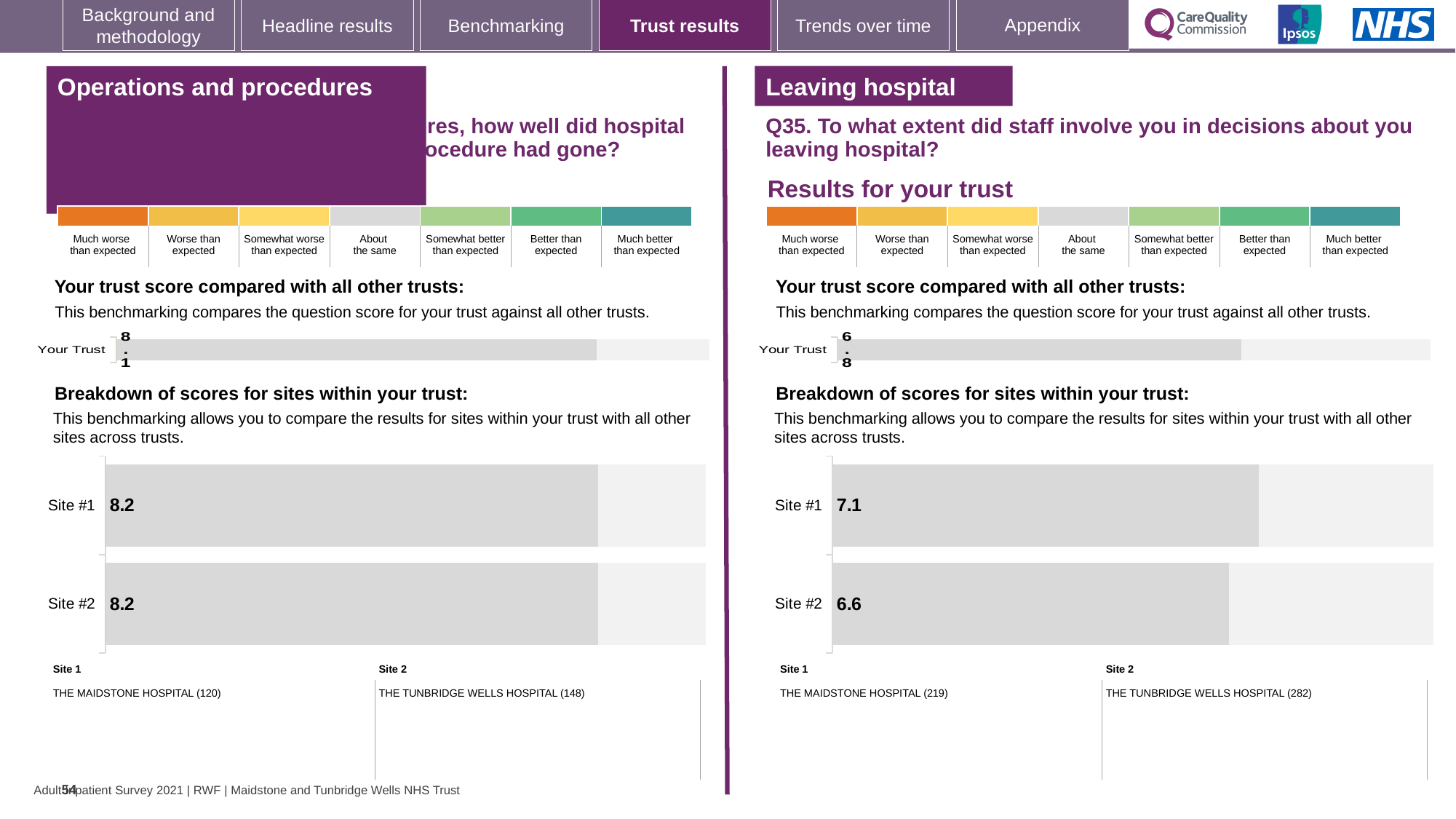
In the 'Operations and procedures' site breakdown chart, what is the score for Site #1? 8.2 In the 'Leaving hospital' site breakdown chart, which site has the higher score? Site #1 In the 'Leaving hospital' site breakdown chart, what is the score for Site #2? 6.6 What type of chart is used for the site breakdown in the 'Leaving hospital' section? Bar chart In the 'Operations and procedures' section, what is the score shown for Your Trust in the trust comparison chart? 8.1 In the 'Leaving hospital' site breakdown chart, which hospital is listed as Site 2? THE TUNBRIDGE WELLS HOSPITAL (282) In the 'Leaving hospital' section, what is the score shown for Your Trust in the trust comparison chart? 6.8 In the 'Leaving hospital' site breakdown chart, what is the score for Site #1? 7.1 In the 'Leaving hospital' site breakdown chart, what is the difference between the Site #1 and Site #2 scores? 0.5 In the 'Operations and procedures' site breakdown chart, what is the score for Site #2? 8.2 How many sites are shown in the 'Operations and procedures' site breakdown chart? 2 In the 'Leaving hospital' site breakdown chart, is the score for Site #1 larger or smaller than the score for Site #2? larger